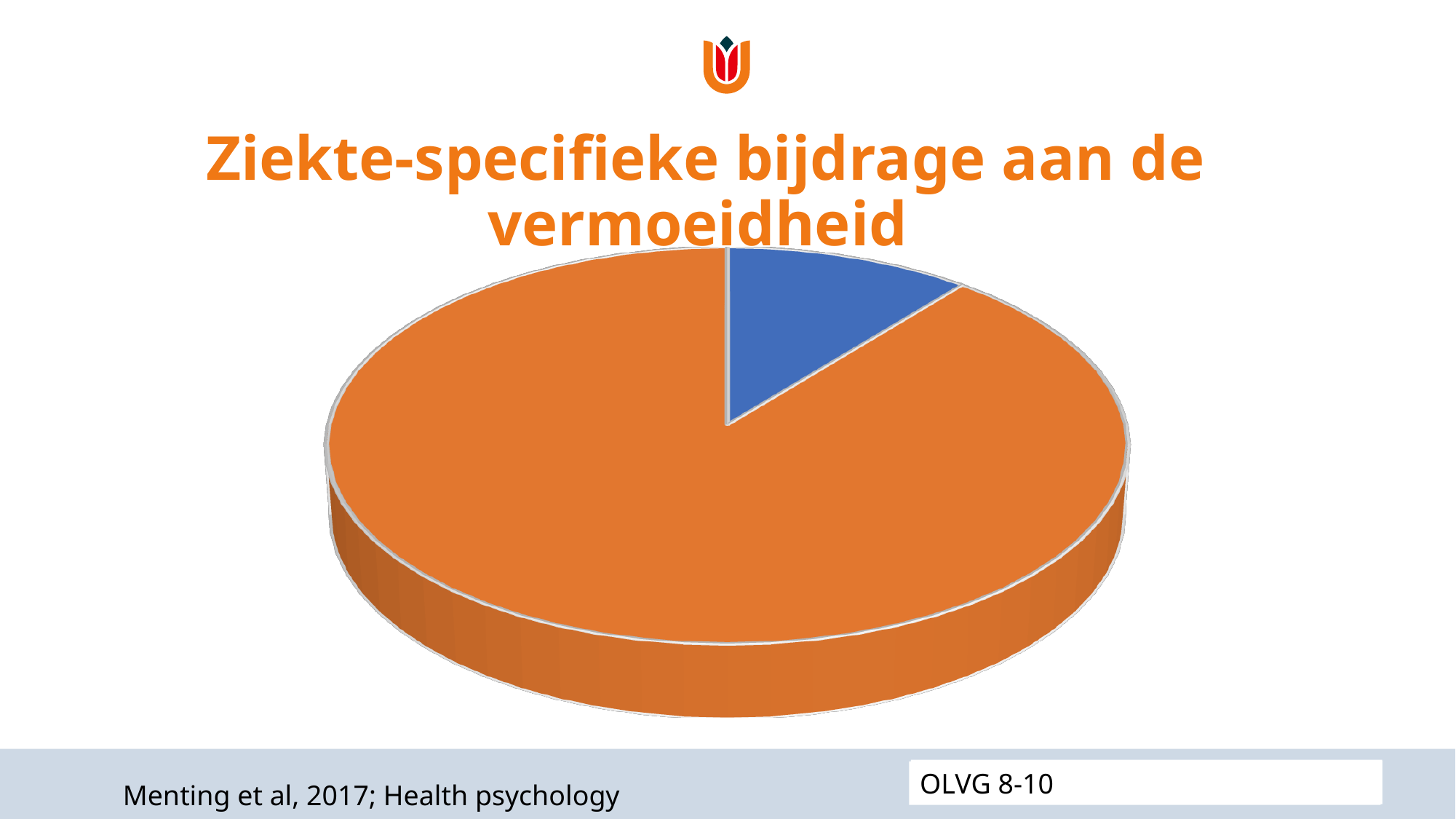
How many slices does the pie chart have? 2 Does the pie chart display a legend? No Which slice of the pie chart is larger, the blue one or the orange one? orange What is the title of the chart on the slide? Ziekte-specifieke bijdrage aan de vermoeidheid Which colour slice takes up the smallest share of the pie chart? blue Which colour slice takes up the largest share of the pie chart? orange What kind of chart is shown on the slide? pie chart